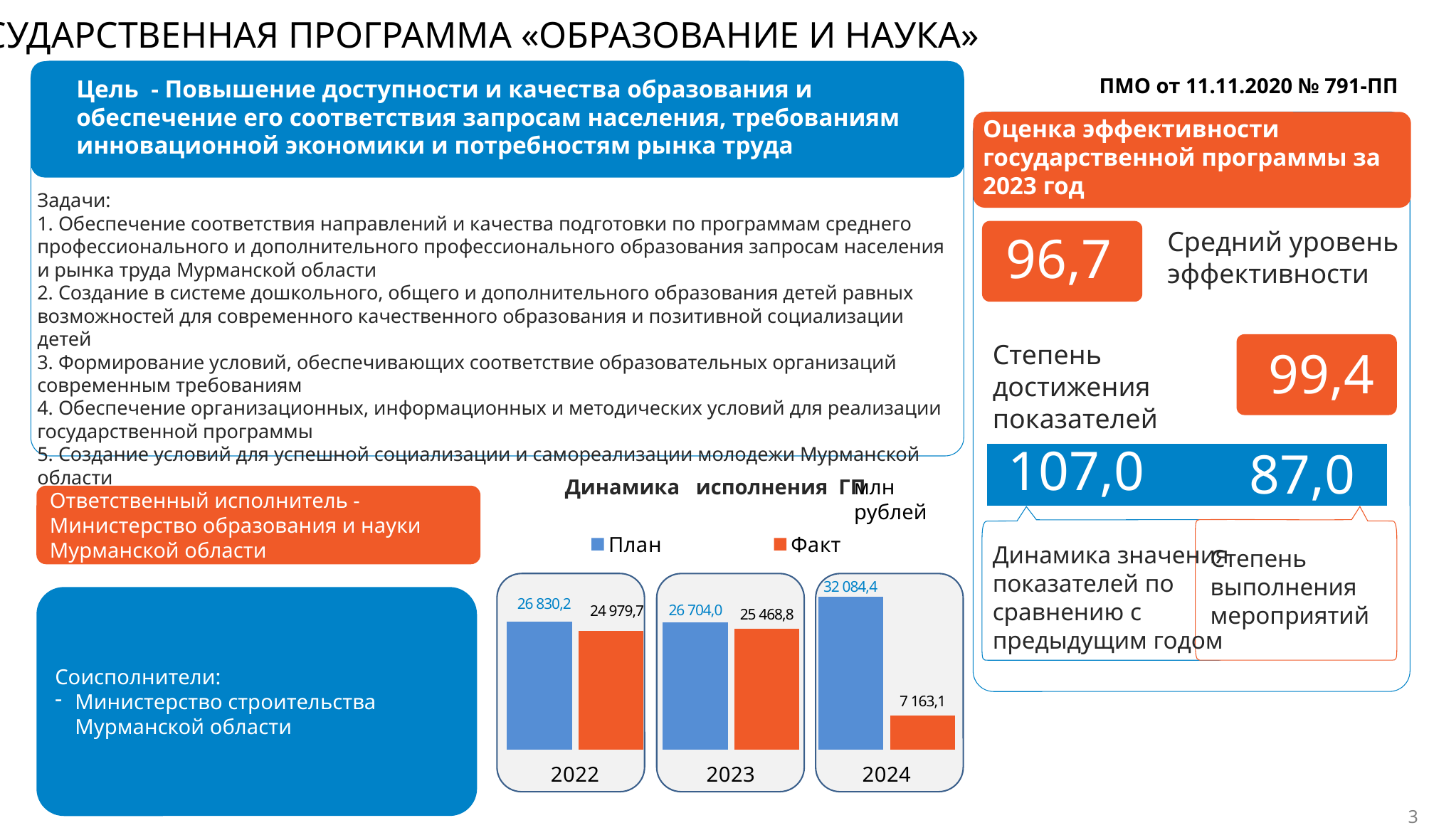
Which is larger in the chart 'Динамика исполнения ГП': the Факт value for 2022 or the Факт value for 2023? 2023 What is the planned (План) value for 2022 in the chart 'Динамика исполнения ГП'? 26 830,2 How many years are shown on the x axis of the chart 'Динамика исполнения ГП'? 3 What is the difference between the План and Факт values for 2022 in the chart 'Динамика исполнения ГП'? 1 850,5 How many series does the legend of the chart 'Динамика исполнения ГП' list? 2 What is the actual (Факт) value for 2024 in the chart 'Динамика исполнения ГП'? 7 163,1 In which year is the planned (План) value highest in the chart 'Динамика исполнения ГП'? 2024 What is the planned (План) value for 2024 in the chart 'Динамика исполнения ГП'? 32 084,4 What is the difference between the План and Факт values for 2024 in the chart 'Динамика исполнения ГП'? 24 921,3 What is the actual (Факт) value for 2023 in the chart 'Динамика исполнения ГП'? 25 468,8 What type of chart is 'Динамика исполнения ГП'? Bar chart In which year is the actual (Факт) value lowest in the chart 'Динамика исполнения ГП'? 2024